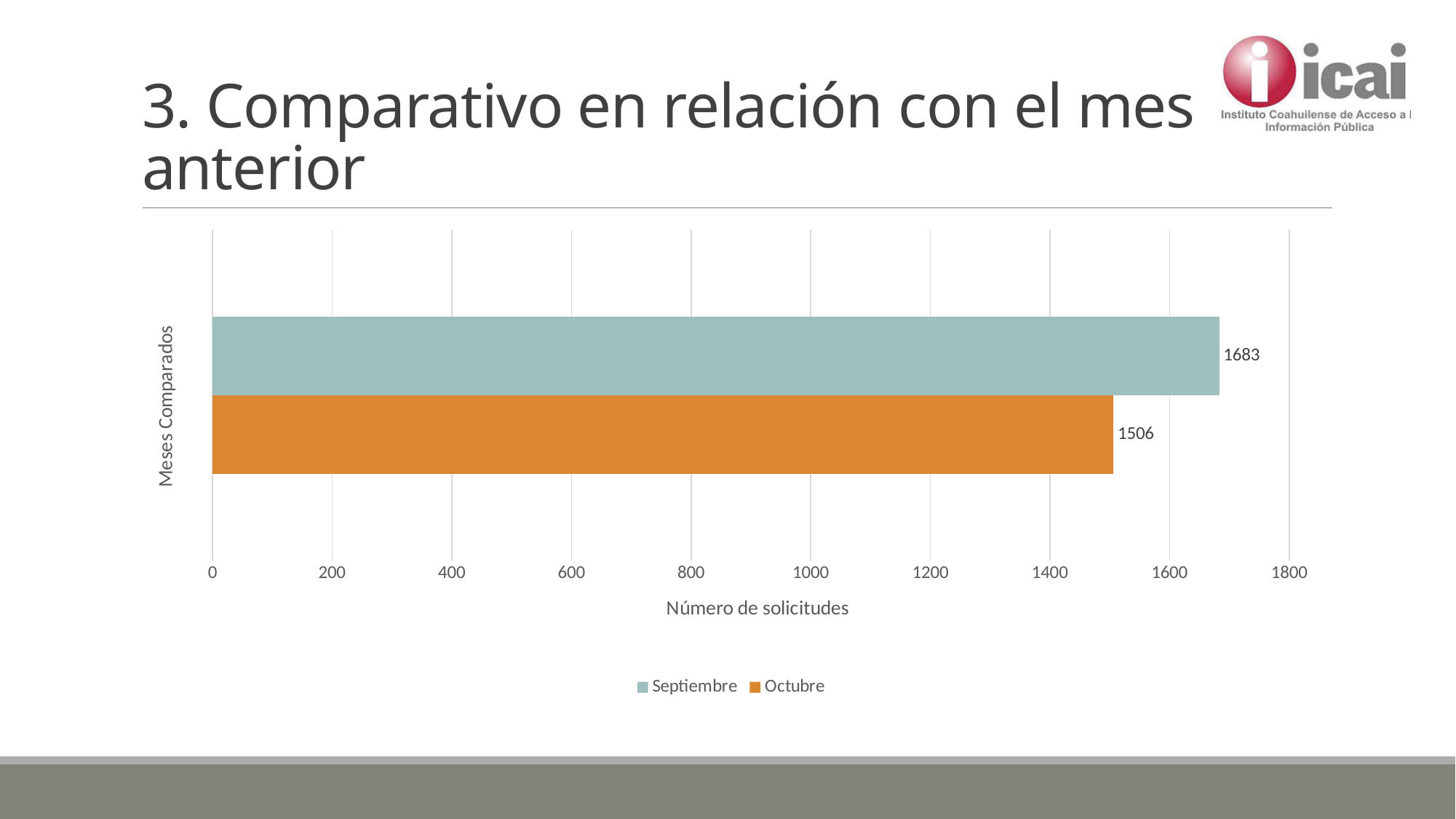
Which series has the lower value? Octubre What is the maximum value shown on the horizontal axis? 1800 Is the value for Septiembre greater or less than 1600? greater What kind of chart is shown on the slide? bar chart What is the label of the vertical axis? Meses Comparados How many series does the legend list? 2 Which series has the higher value, Septiembre or Octubre? Septiembre Is the value for Octubre greater or less than 1600? less What is the difference between the Septiembre and Octubre values? 177 What is the label of the horizontal axis? Número de solicitudes What is the value for Octubre? 1506 What is the value for Septiembre? 1683